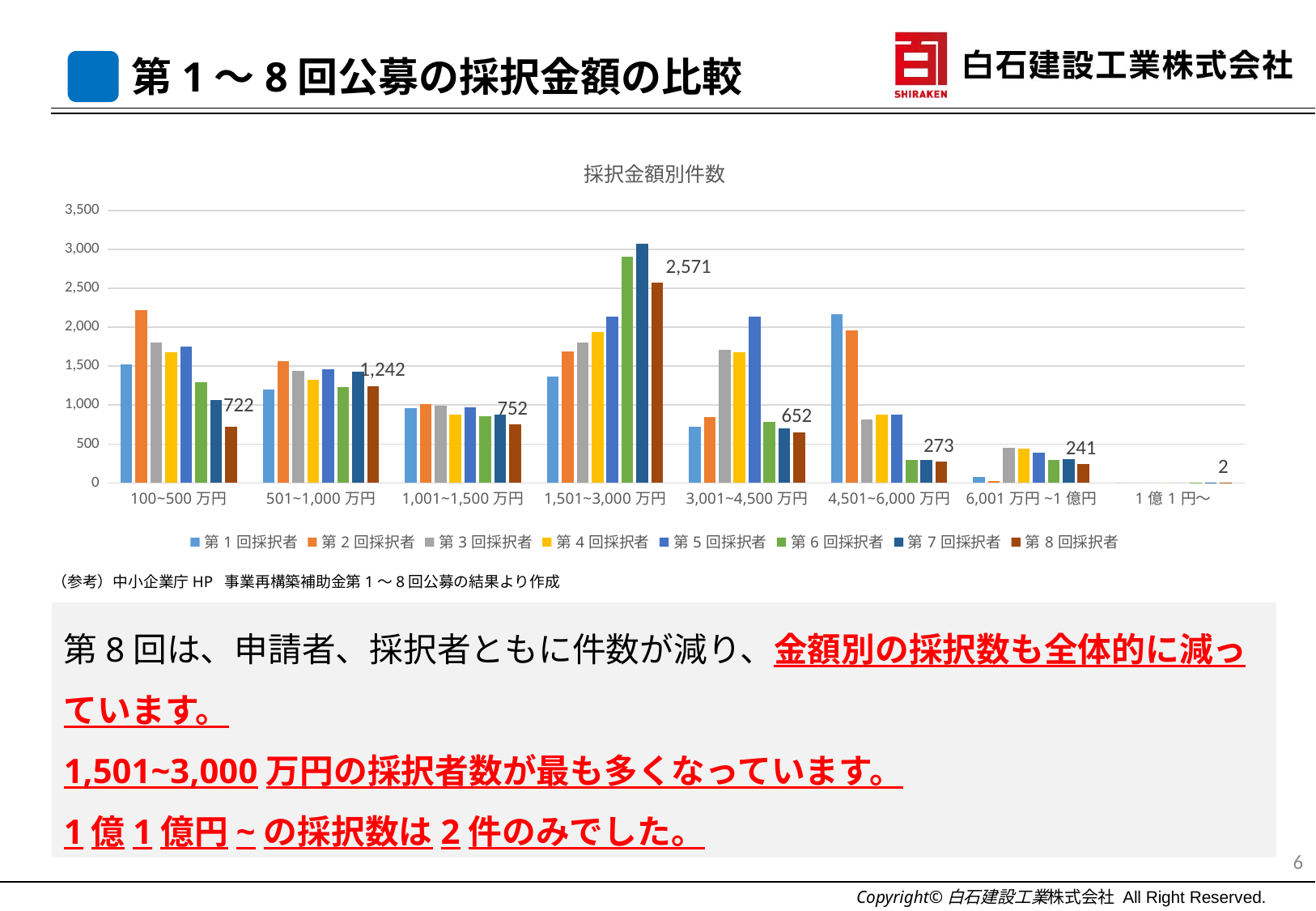
What is the value for 第8回採択者 in the 501~1,000 万円 category? 1,242 What is the difference between the 第8回採択者 values for 1,501~3,000 万円 and 100~500 万円? 1,849 What is the value for 第8回採択者 in the 100~500 万円 category? 722 Among the labelled 第8回採択者 values, which category has the highest value? 1,501~3,000 万円 What kind of chart is shown on the slide? Bar chart What is the value for 第8回採択者 in the 1,501~3,000 万円 category? 2,571 How many series does the legend list? 8 For 第8回採択者, which is larger: the value for 501~1,000 万円 or the value for 1,001~1,500 万円? 501~1,000 万円 Among the labelled 第8回採択者 values, which category has the lowest value? 1 億 1 円～ What is the value for 第8回採択者 in the 1 億 1 円～ category? 2 Is the value for 第6回採択者 in the 4,501~6,000 万円 category greater or less than 500? less Is the value for 第2回採択者 in the 100~500 万円 category greater or less than 2,000? greater